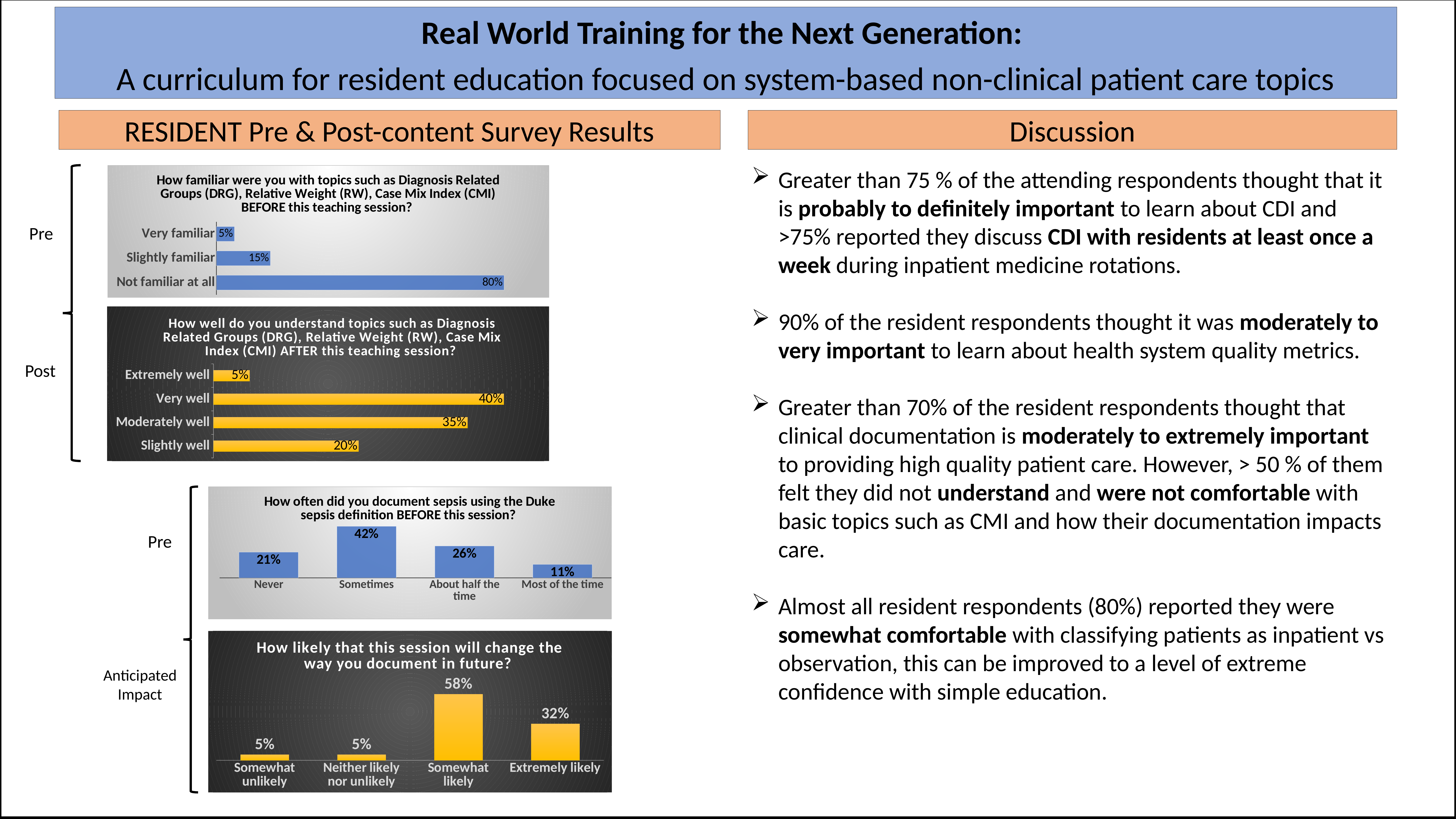
In the chart titled "How familiar were you with topics such as Diagnosis Related Groups (DRG)... BEFORE this teaching session?", which category has the lowest value? Very familiar In the chart titled "How familiar were you with topics such as Diagnosis Related Groups (DRG)... BEFORE this teaching session?", how many categories are shown? 3 What type of chart is the one titled "How likely that this session will change the way you document in future?"? Bar chart In the chart titled "How familiar were you with topics such as Diagnosis Related Groups (DRG)... BEFORE this teaching session?", what percentage of respondents were "Not familiar at all"? 80% In the chart titled "How well do you understand topics such as Diagnosis Related Groups (DRG)... AFTER this teaching session?", what is the difference between "Very well" and "Slightly well"? 20% In the chart titled "How likely that this session will change the way you document in future?", what is the difference between "Somewhat likely" and "Extremely likely"? 26% In the chart titled "How often did you document sepsis using the Duke sepsis definition BEFORE this session?", what is the value for "Sometimes"? 42% In the chart titled "How well do you understand topics such as Diagnosis Related Groups (DRG)... AFTER this teaching session?", what is the value for "Moderately well"? 35% In the chart titled "How often did you document sepsis using the Duke sepsis definition BEFORE this session?", which is larger: "Never" or "About half the time"? About half the time In the chart titled "How often did you document sepsis using the Duke sepsis definition BEFORE this session?", which category has the lowest value? Most of the time In the chart titled "How well do you understand topics such as Diagnosis Related Groups (DRG)... AFTER this teaching session?", which category has the highest value? Very well In the chart titled "How likely that this session will change the way you document in future?", what is the value for "Extremely likely"? 32%